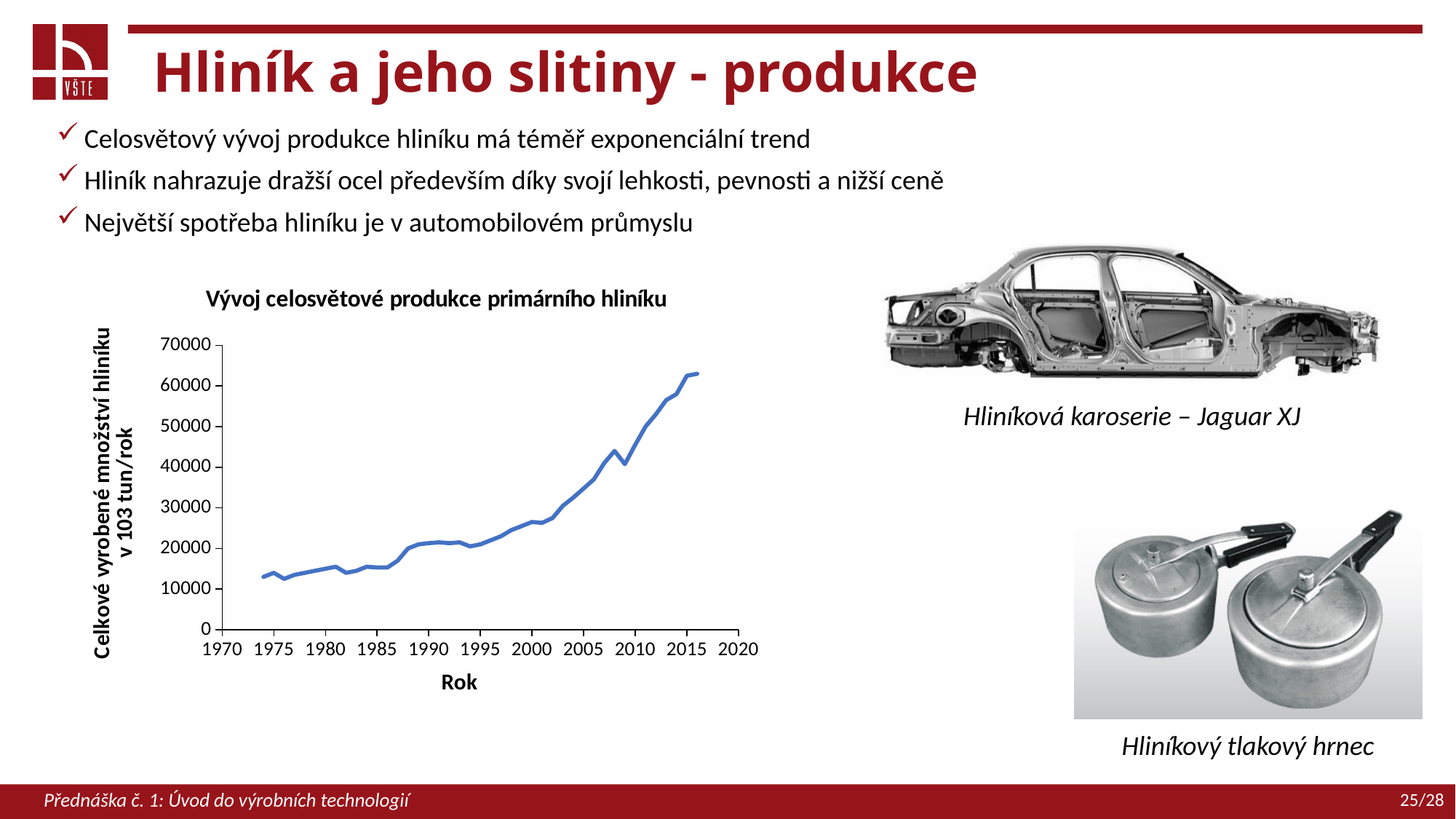
What is the highest value shown on the y axis of the chart? 70000 Is the value for 2015 greater or less than 50000? greater Is the value for 1990 greater or less than 30000? less Is the value for 2010 greater or less than 40000? greater What is the label of the x axis of the chart? Rok Which is larger, the value for 2005 or the value for 1985? 2005 What is the title of the chart? Vývoj celosvětové produkce primárního hliníku What kind of chart is shown on the slide? line chart Do the values in the chart generally rise or fall from 1975 to 2015? rise